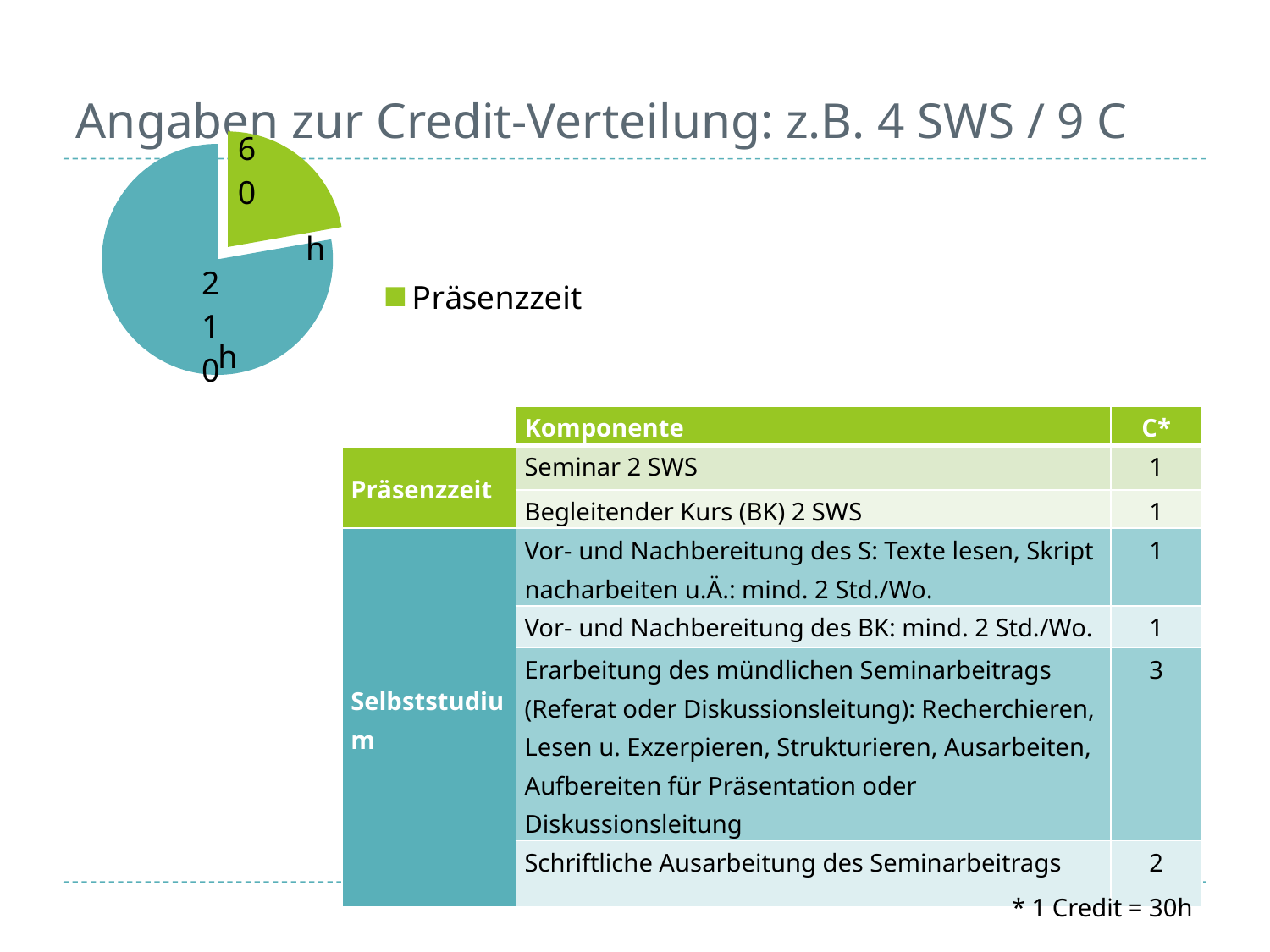
What value is shown for the Präsenzzeit slice of the pie chart? 60 h Which slice of the pie chart is larger: the green Präsenzzeit slice or the teal slice? the teal slice What is the difference between the teal slice (210 h) and the Präsenzzeit slice (60 h) in the pie chart? 150 h How many entries does the pie chart's legend list? 1 What value is shown on the large teal slice of the pie chart? 210 h How many slices does the pie chart have? 2 What colour is the Präsenzzeit slice in the pie chart? green What is the only entry shown in the pie chart's legend? Präsenzzeit What kind of chart is shown on the slide? pie chart What is the total of the two slice values shown in the pie chart? 270 h Which slice of the pie chart has the smallest value? Präsenzzeit